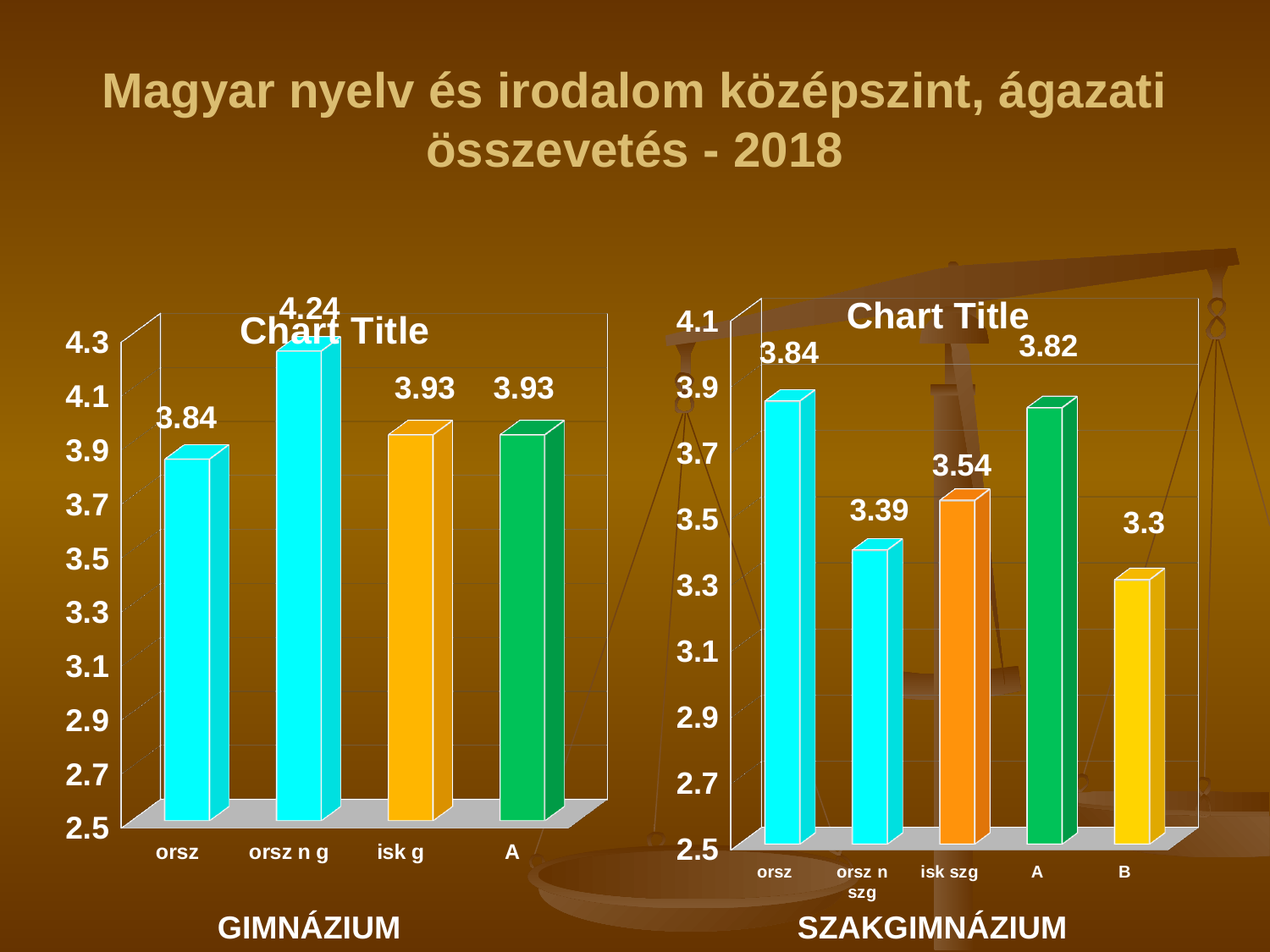
In the left chart (GIMNÁZIUM), what is the value for orsz n g? 4.24 What type of chart is the right chart (SZAKGIMNÁZIUM)? Bar chart In the right chart (SZAKGIMNÁZIUM), what is the value for isk szg? 3.54 In the left chart (GIMNÁZIUM), what is the difference between the values for orsz n g and orsz? 0.4 In the right chart (SZAKGIMNÁZIUM), what is the difference between the values for orsz and orsz n szg? 0.45 In the left chart (GIMNÁZIUM), which category has the lowest value? orsz In the left chart (GIMNÁZIUM), which category has the highest value? orsz n g In the right chart (SZAKGIMNÁZIUM), which category has the lowest value? B In the left chart (GIMNÁZIUM), what is the value for isk g? 3.93 In the right chart (SZAKGIMNÁZIUM), which is larger, the value for orsz n szg or the value for A? A In the left chart (GIMNÁZIUM), how many bars are plotted? 4 In the right chart (SZAKGIMNÁZIUM), what is the value for B? 3.3